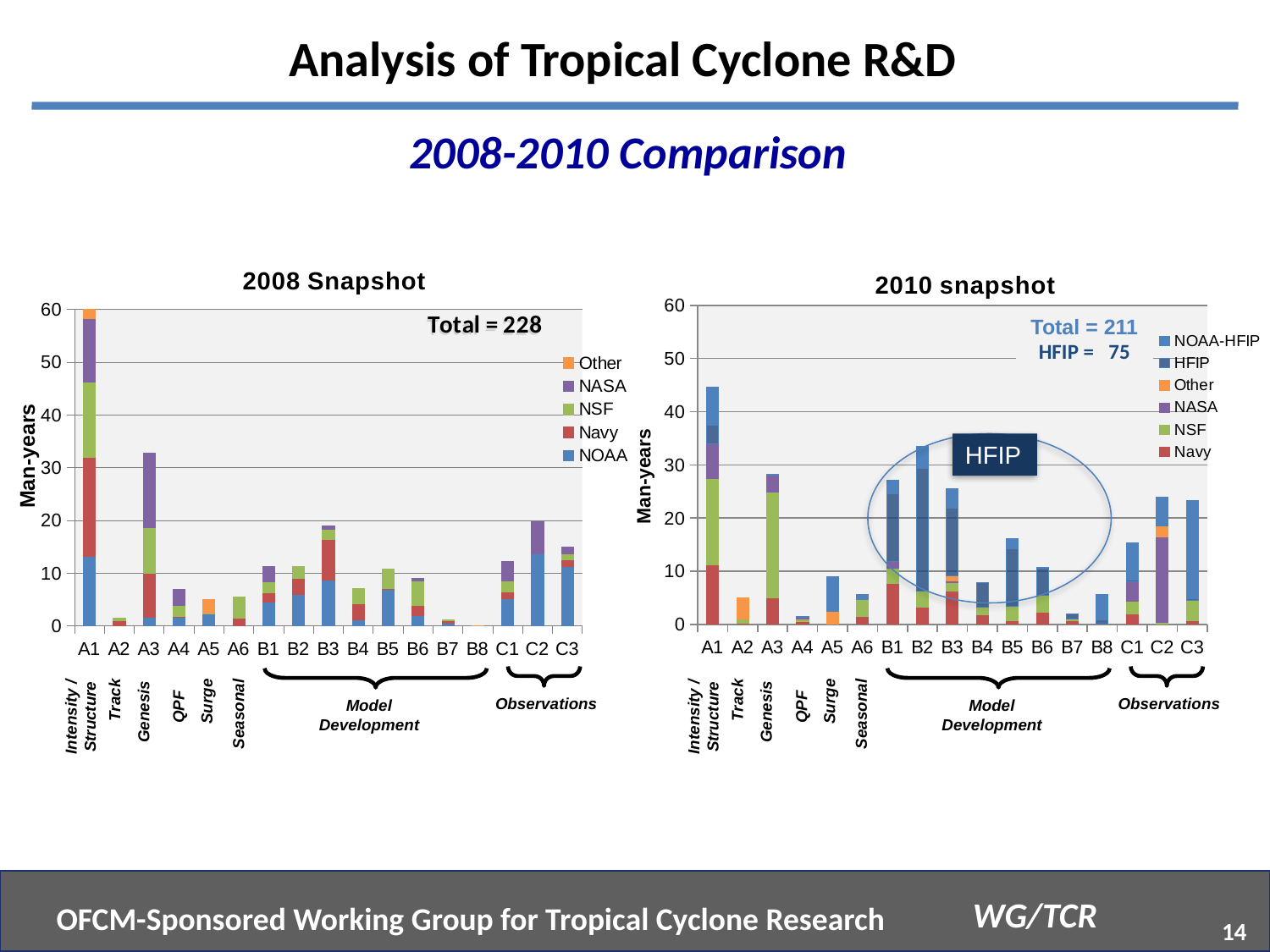
In the 2008 Snapshot chart, is the total for A1 greater or less than 50? greater How many series does the legend of the 2008 Snapshot chart list? 5 In the 2008 Snapshot chart, which bar is taller, C2 or C3? C2 How many series does the legend of the 2010 snapshot chart list? 6 What total is printed on the 2010 snapshot chart? Total = 211 In the 2008 Snapshot chart, which category has the tallest bar? A1 How many categories are shown on the x axis of the 2010 snapshot chart? 17 In the 2010 snapshot chart, is the total for B2 greater or less than 30? greater In the 2010 snapshot chart, is the total for A1 greater or less than 40? greater What kind of chart is the 2008 Snapshot chart? Stacked bar chart In the 2010 snapshot chart, which category has the tallest bar? A1 In the 2010 snapshot chart, which bar is taller, B2 or B3? B2